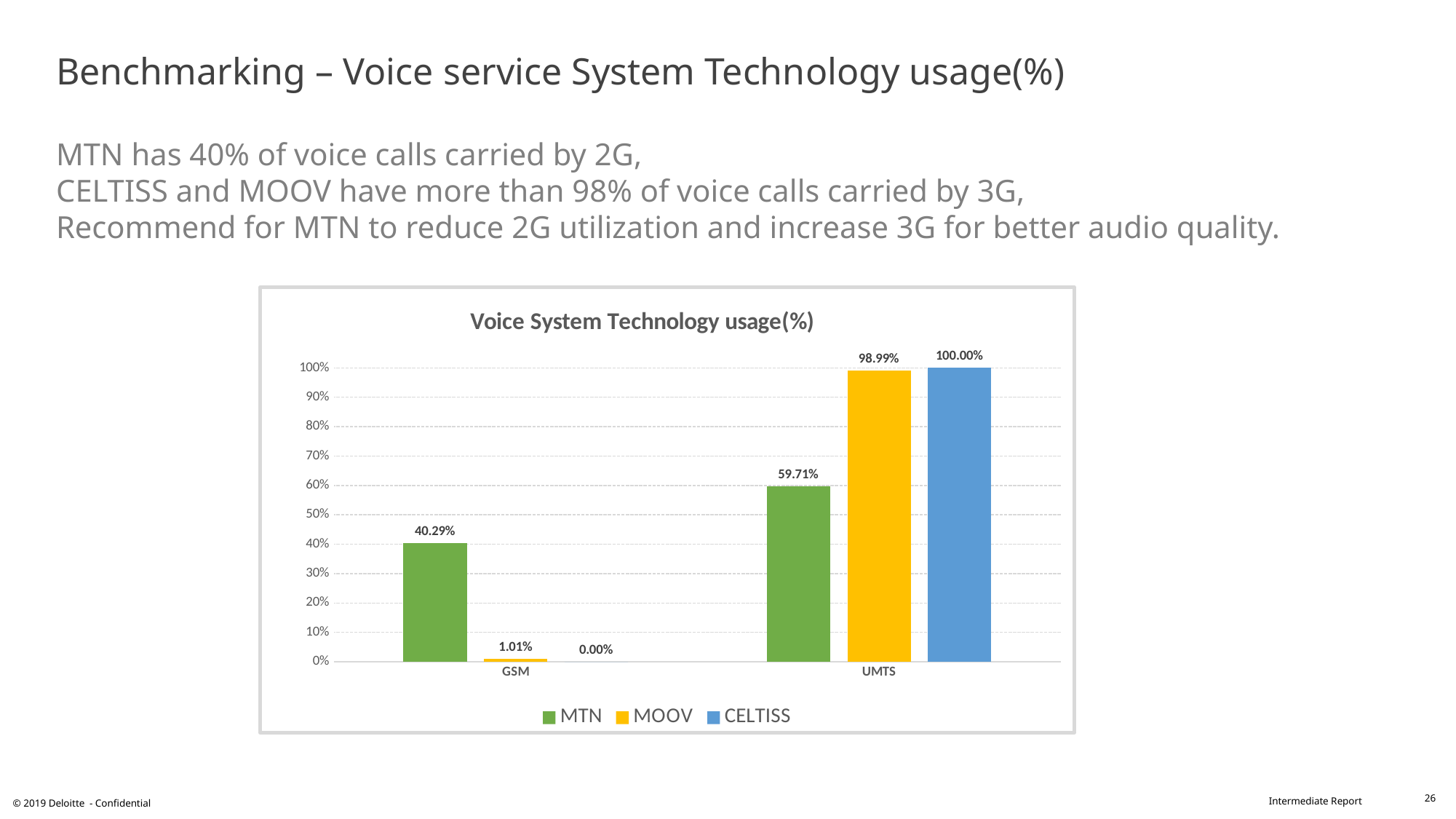
What is the CELTISS value for GSM? 0.00% What is the MTN value for GSM? 40.29% How many categories are shown on the x axis? 2 What kind of chart is shown on the slide? Bar chart Which is larger for GSM: the MTN value or the MOOV value? MTN What is the MTN value for UMTS? 59.71% Which operator has the highest value for UMTS? CELTISS Which operator has the lowest value for GSM? CELTISS What is the MOOV value for UMTS? 98.99% How many series does the legend list? 3 What is the title of the chart? Voice System Technology usage(%) What is the difference between the MTN values for UMTS and GSM? 19.42%